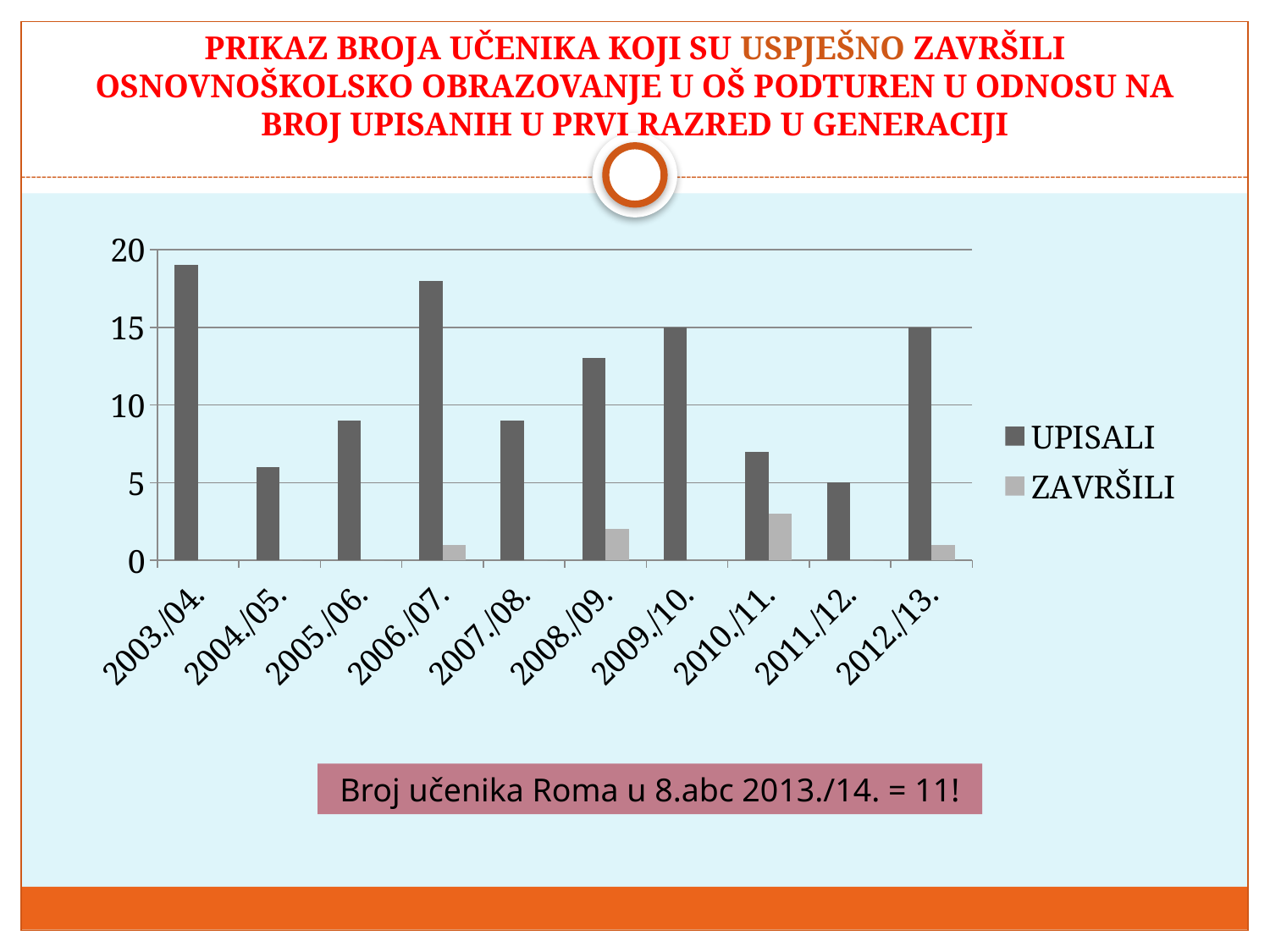
What is the UPISALI value for 2011./12.? 5 Which school year has the highest ZAVRŠILI value? 2010./11. Which is larger, the UPISALI value for 2003./04. or for 2004./05.? 2003./04. Is the UPISALI value for 2008./09. greater or less than 10? greater What kind of chart is shown on the slide? bar chart Is the UPISALI value for 2004./05. greater or less than 10? less How many school-year categories are shown on the x axis? 10 How many series does the legend list? 2 What are the two legend entries of the chart? UPISALI and ZAVRŠILI What is the UPISALI value for 2012./13.? 15 Is the UPISALI value for 2003./04. greater or less than 15? greater What is the UPISALI value for 2009./10.? 15